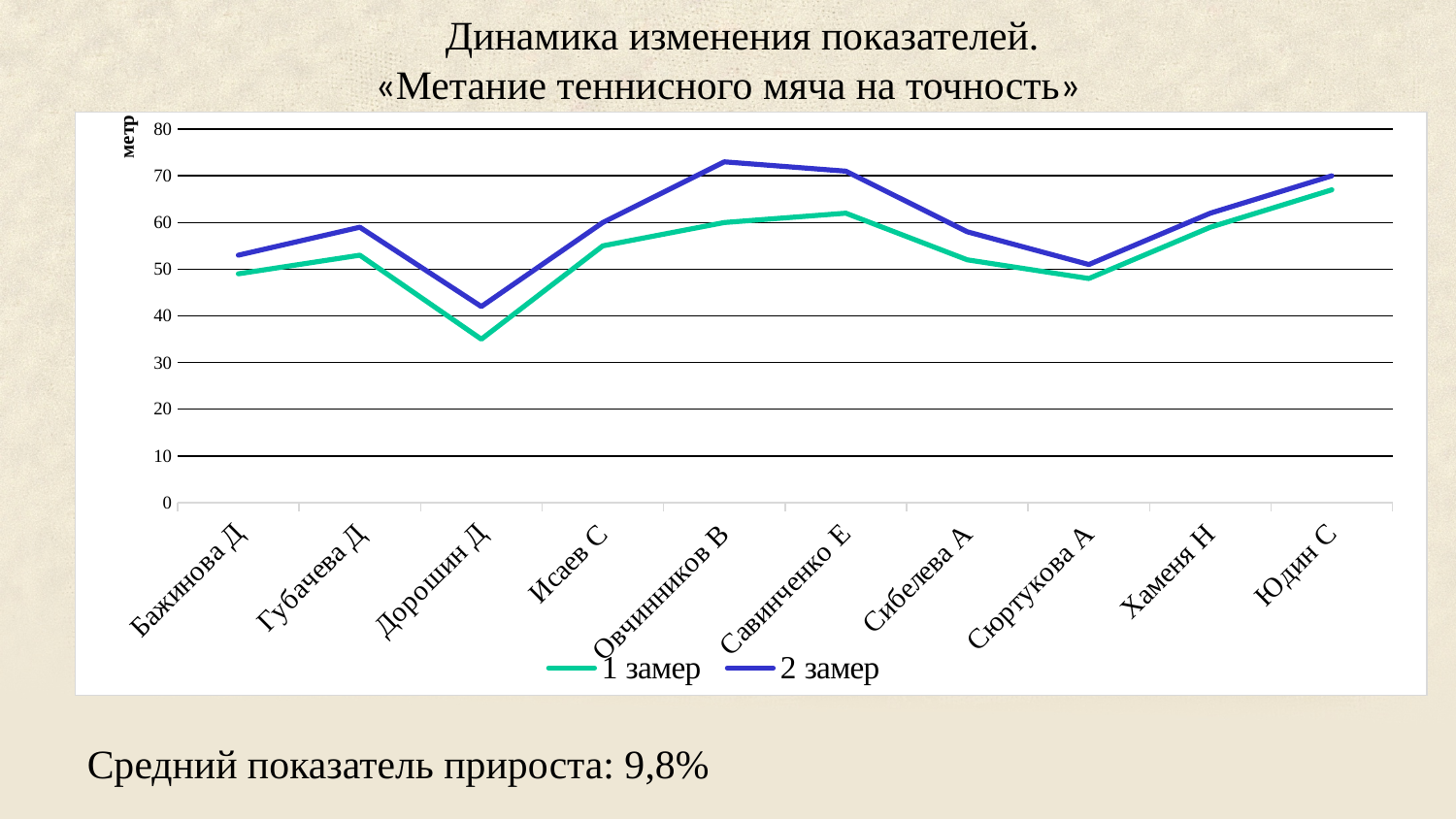
Is the "2 замер" value for Овчинников В greater or less than 70? greater How many series does the legend list? 2 Which person has the lowest value for the "2 замер" series? Дорошин Д What is the "2 замер" value for Юдин С? 70 Which person has the lowest value for the "1 замер" series? Дорошин Д What kind of chart is shown on the slide? line chart Is the "1 замер" value for Дорошин Д greater or less than 40? less For Савинченко Е, which series has the larger value, "1 замер" or "2 замер"? 2 замер What label is shown on the vertical axis? метр How many people (categories) are plotted along the x axis? 10 Which person has the highest value for the "2 замер" series? Овчинников В